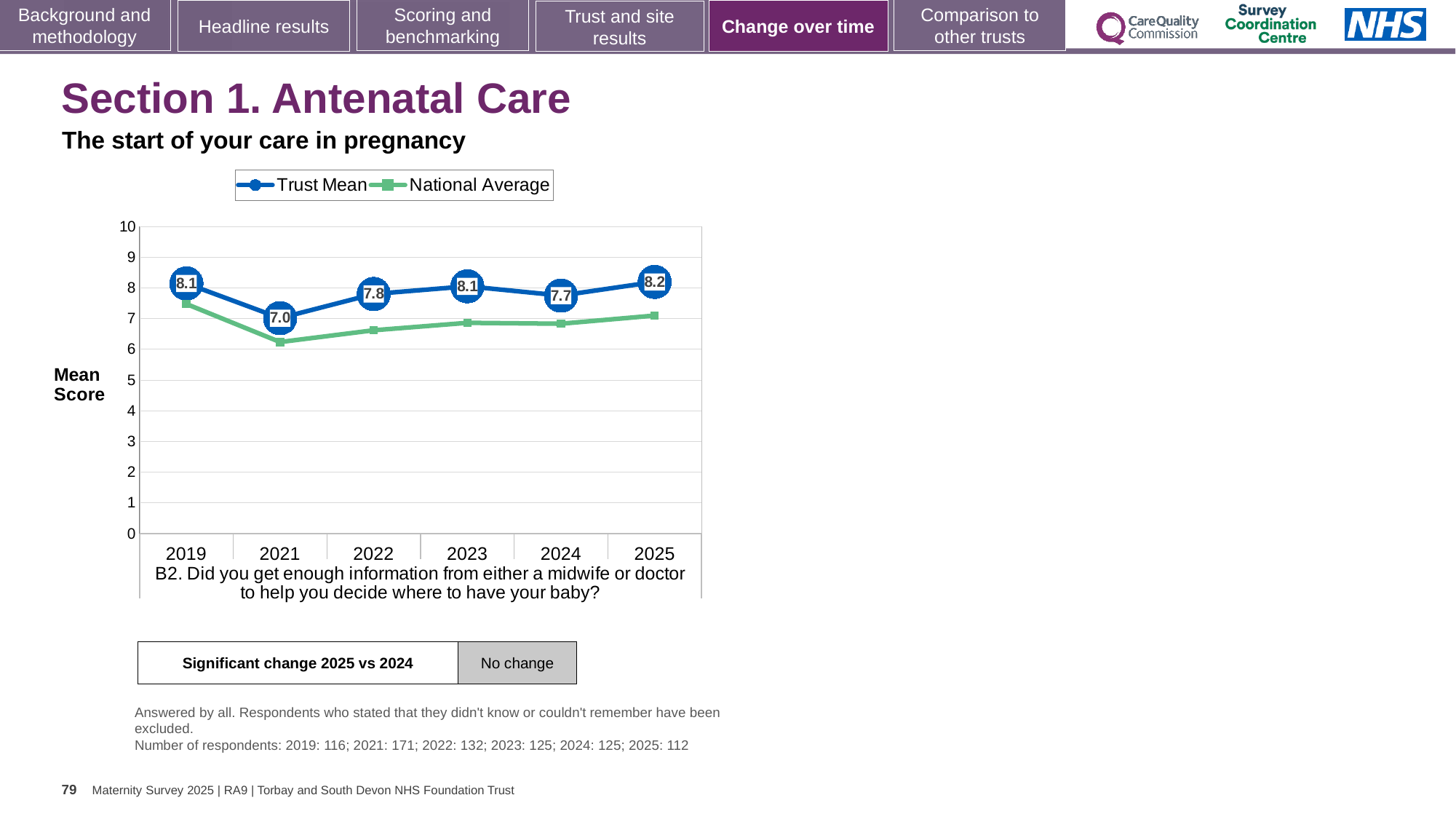
What kind of chart is shown on the slide? Line chart What is the difference between the Trust Mean scores for 2025 and 2021? 1.2 How many series does the chart legend list? 2 Which is larger, the Trust Mean score for 2022 or for 2024? 2022 Is the National Average value for 2025 greater or less than 6? greater What is the Trust Mean score for 2021? 7.0 How many years are shown on the x axis of the chart? 6 In which year is the Trust Mean score highest? 2025 What is the Trust Mean score for 2024? 7.7 Is the National Average value for 2021 greater or less than 7? less In which year is the Trust Mean score lowest? 2021 What is the Trust Mean score for 2025? 8.2